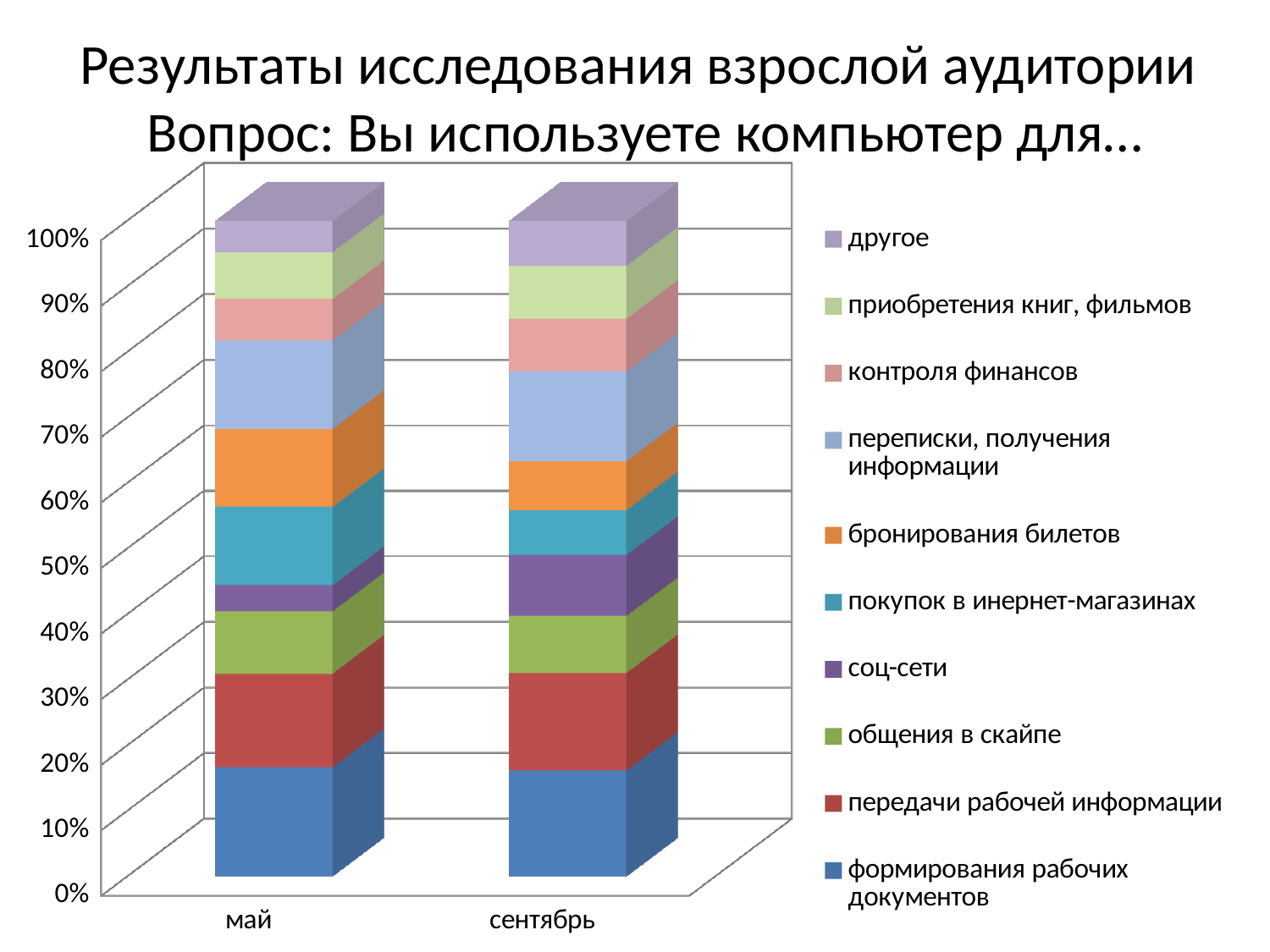
How many categories are shown on the x axis? 2 Which series is listed at the bottom of the legend? формирования рабочих документов Which series is listed at the top of the legend? другое Which month has the larger share for бронирования билетов? май How many series does the legend list? 10 What are the two categories on the x axis? май, сентябрь What is the total height of the stacked bar for сентябрь? 100% Which month has the larger share for соц-сети? сентябрь What is the total height of the stacked bar for май? 100% Which month has the larger share for покупок в инернет-магазинах? май What kind of chart is shown on the slide? stacked bar chart